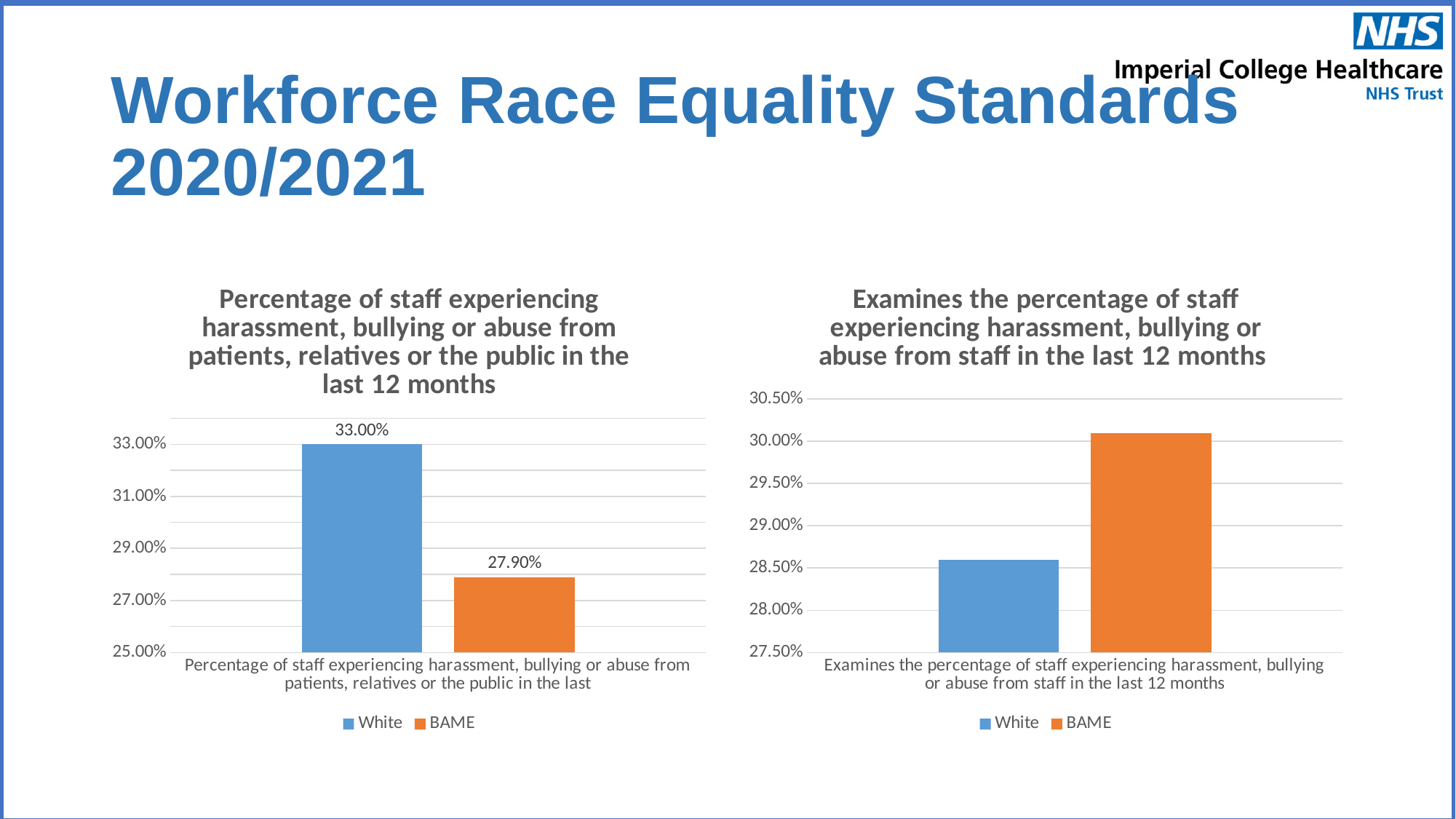
In the right chart (harassment from staff), is the value for White staff greater or less than 28.50%? greater In the left chart (harassment from patients, relatives or the public), what is the value for BAME staff? 27.90% In the left chart, which colour represents BAME staff? Orange In the left chart (harassment from patients, relatives or the public), what is the difference between the White and BAME values? 5.10% In the right chart (harassment from staff), is the value for White staff greater or less than 29.00%? less What kind of chart is the left chart? Bar chart In the left chart (harassment from patients, relatives or the public), what is the value for White staff? 33.00% What is the title of the right chart? Examines the percentage of staff experiencing harassment, bullying or abuse from staff in the last 12 months In the left chart (harassment from patients, relatives or the public), which group has the higher value? White In the right chart (harassment from staff), which group has the higher value? BAME In the right chart (harassment from staff), is the value for BAME staff greater or less than 30.00%? greater How many series does the legend of the right chart list? 2